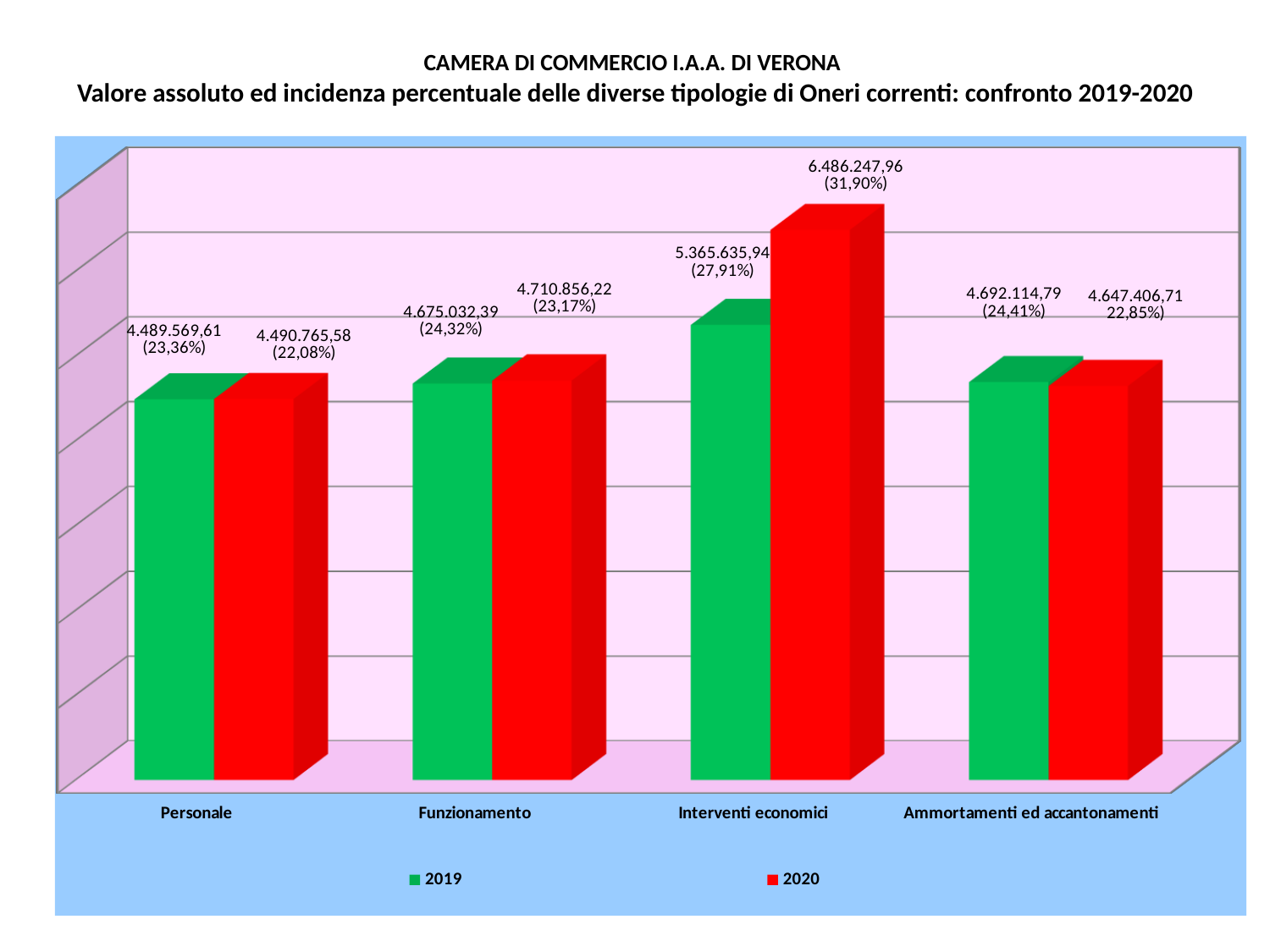
Which category has the lowest value in 2019? Personale How many categories are shown on the x axis? 4 What is the value for Ammortamenti ed accantonamenti in 2019? 4.692.114,79 What percentage share is shown for Funzionamento in 2020? 23,17% What kind of chart is shown on the slide? Bar chart What is the value for Personale in 2019? 4.489.569,61 How many series does the legend list? 2 What is the difference between the 2019 and 2020 values for Ammortamenti ed accantonamenti? 44.708,08 What is the difference between the 2020 and 2019 values for Interventi economici? 1.120.612,02 What is the value for Interventi economici in 2020? 6.486.247,96 Which category has the highest value in 2020? Interventi economici For Interventi economici, which year has the larger value, 2019 or 2020? 2020